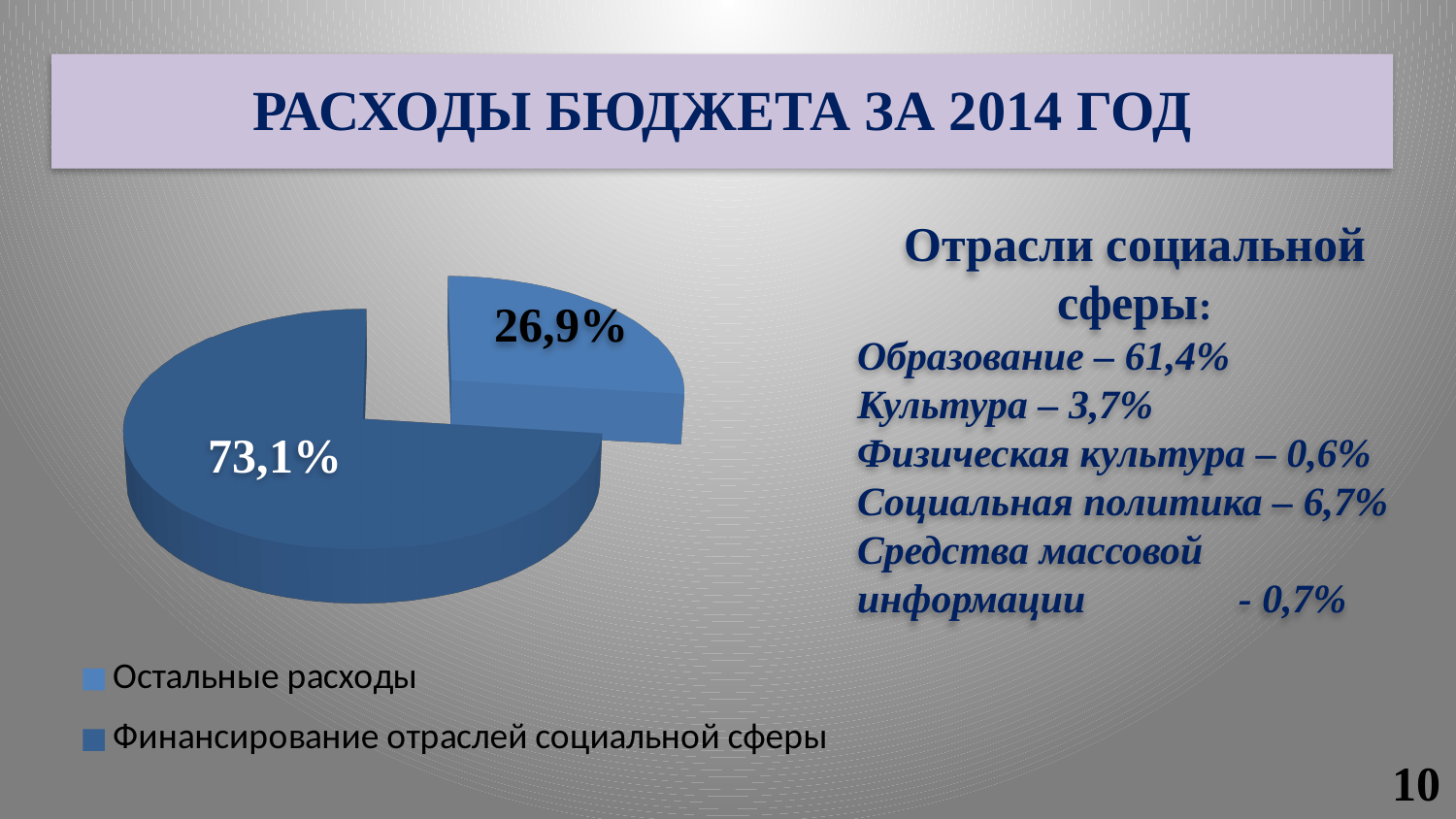
What is the difference in percentage points between the two slices of the pie? 46,2 Which slice of the pie is the smallest? Остальные расходы How many entries does the legend list? 2 Is the share for "Остальные расходы" greater or less than 50%? less Which legend entry is shown in the lighter blue colour? Остальные расходы Which slice of the pie is the largest? Финансирование отраслей социальной сферы What share of the pie does "Финансирование отраслей социальной сферы" take? 73,1% Which is larger: the share for "Остальные расходы" or the share for "Финансирование отраслей социальной сферы"? Финансирование отраслей социальной сферы What is the title of the slide containing the chart? РАСХОДЫ БЮДЖЕТА ЗА 2014 ГОД What share of the pie does "Остальные расходы" take? 26,9% What kind of chart is shown on the slide? Pie chart How many slices does the pie chart have? 2